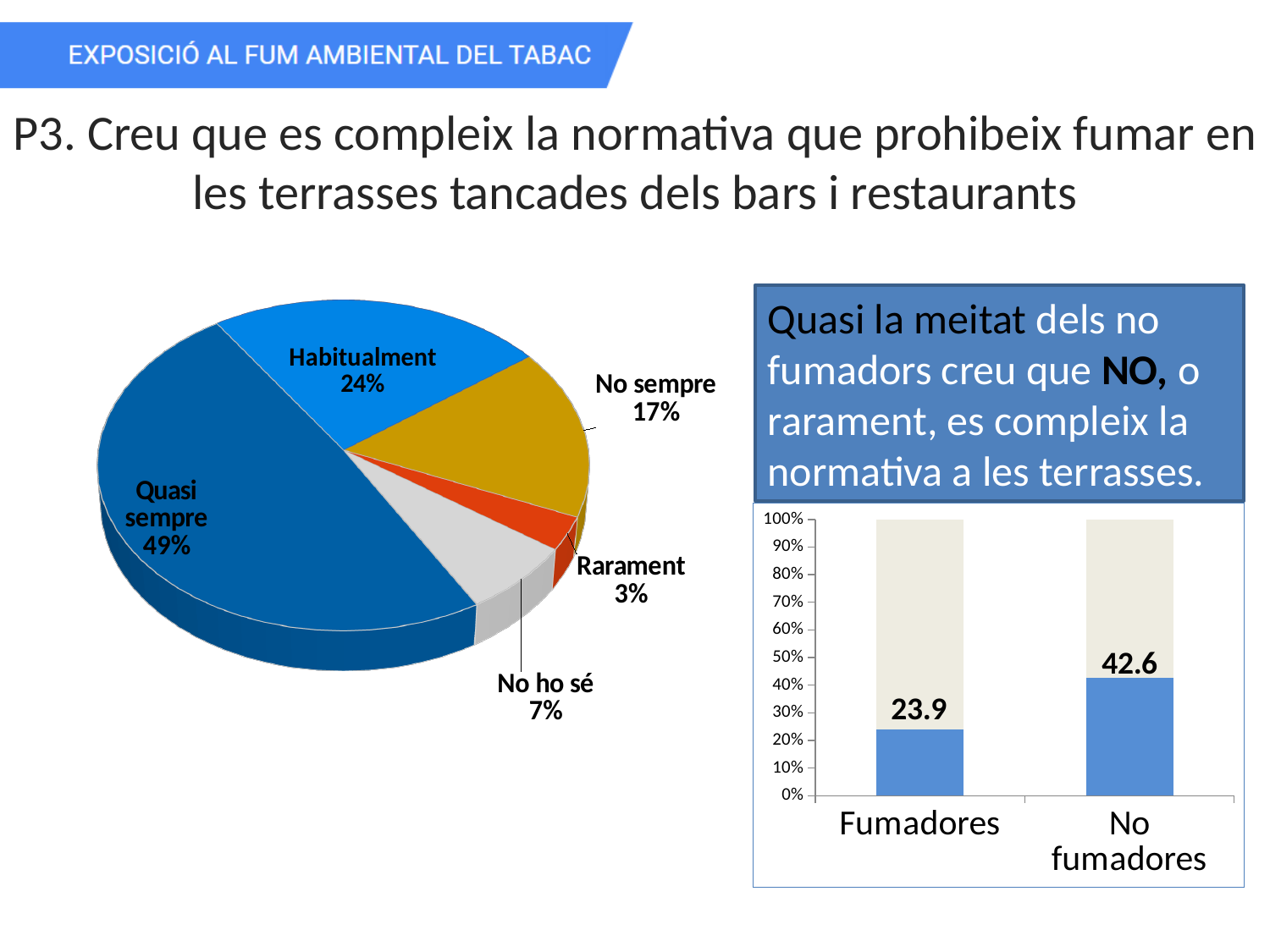
In the pie chart on the left, what share does the 'No sempre' slice have? 17% In the pie chart on the left, which category has the smallest slice? Rarament In the pie chart on the left, what is the difference between the 'Habitualment' and 'No ho sé' shares? 17% In the bar chart on the right, what is the labelled value for 'Fumadores'? 23.9 In the pie chart on the left, what share does the 'Quasi sempre' slice have? 49% In the pie chart on the left, which category has the largest slice? Quasi sempre In the pie chart on the left, how many slices are there? 5 In the pie chart on the left, which is larger, 'No sempre' or 'No ho sé'? No sempre What kind of chart is shown on the right side of the slide? Bar chart In the bar chart on the right, what is the difference between the labelled values for 'No fumadores' and 'Fumadores'? 18.7 In the pie chart on the left, what share does the 'Habitualment' slice have? 24% In the bar chart on the right, what is the labelled value for 'No fumadores'? 42.6